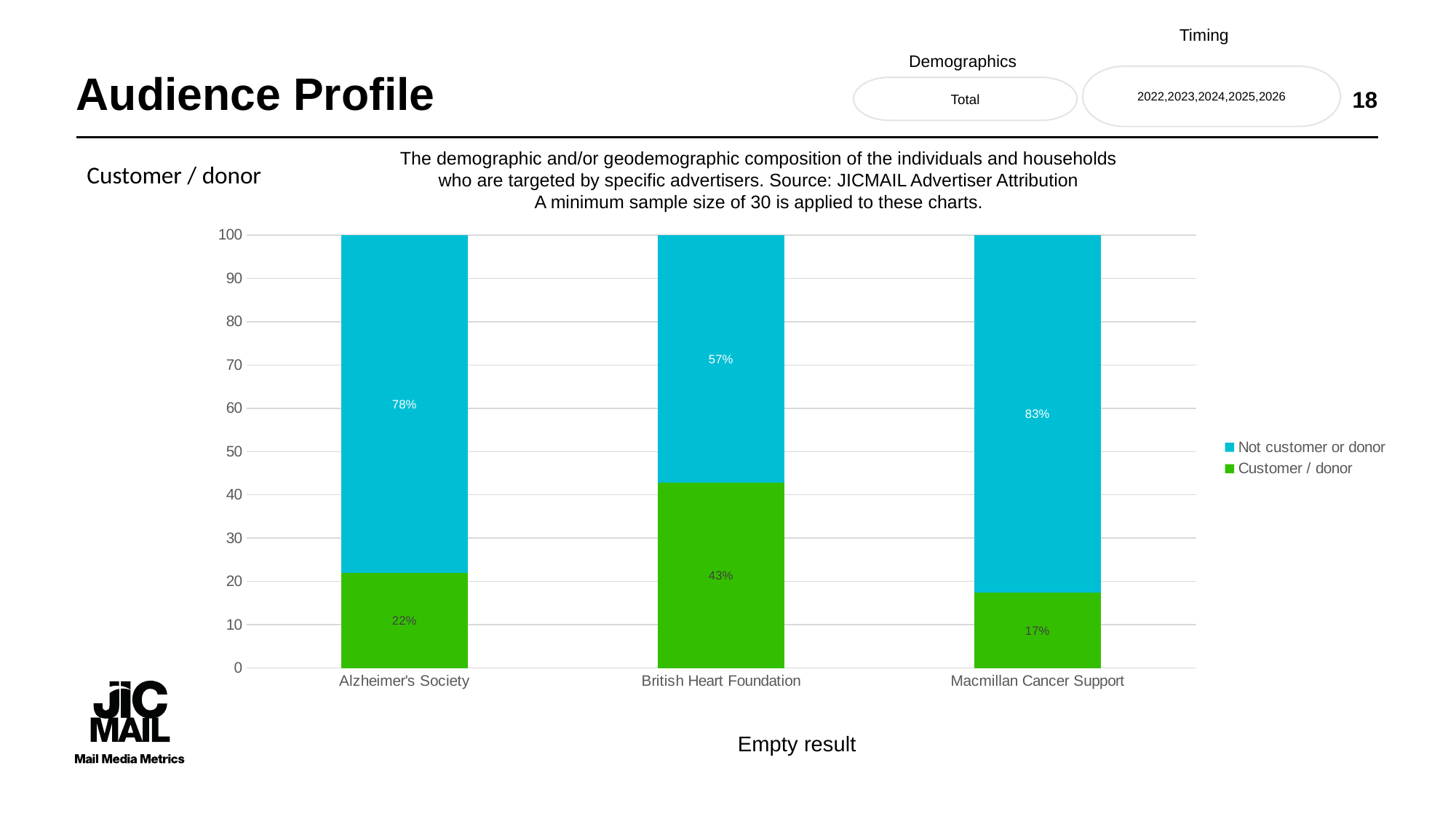
What is the Customer / donor value for Alzheimer's Society? 22% What is the Not customer or donor value for British Heart Foundation? 57% Which advertiser has the lowest Customer / donor share? Macmillan Cancer Support What kind of chart is shown? Stacked bar chart What is the difference between the Customer / donor values for British Heart Foundation and Alzheimer's Society? 21% Which is larger: the Not customer or donor value for Alzheimer's Society or for Macmillan Cancer Support? Macmillan Cancer Support Which advertiser has the highest Customer / donor share? British Heart Foundation What is the Not customer or donor value for Macmillan Cancer Support? 83% What is the Customer / donor value for Macmillan Cancer Support? 17% How many series does the legend list? 2 What is the total of the stacked bar for British Heart Foundation? 100% How many advertisers are shown on the x axis? 3